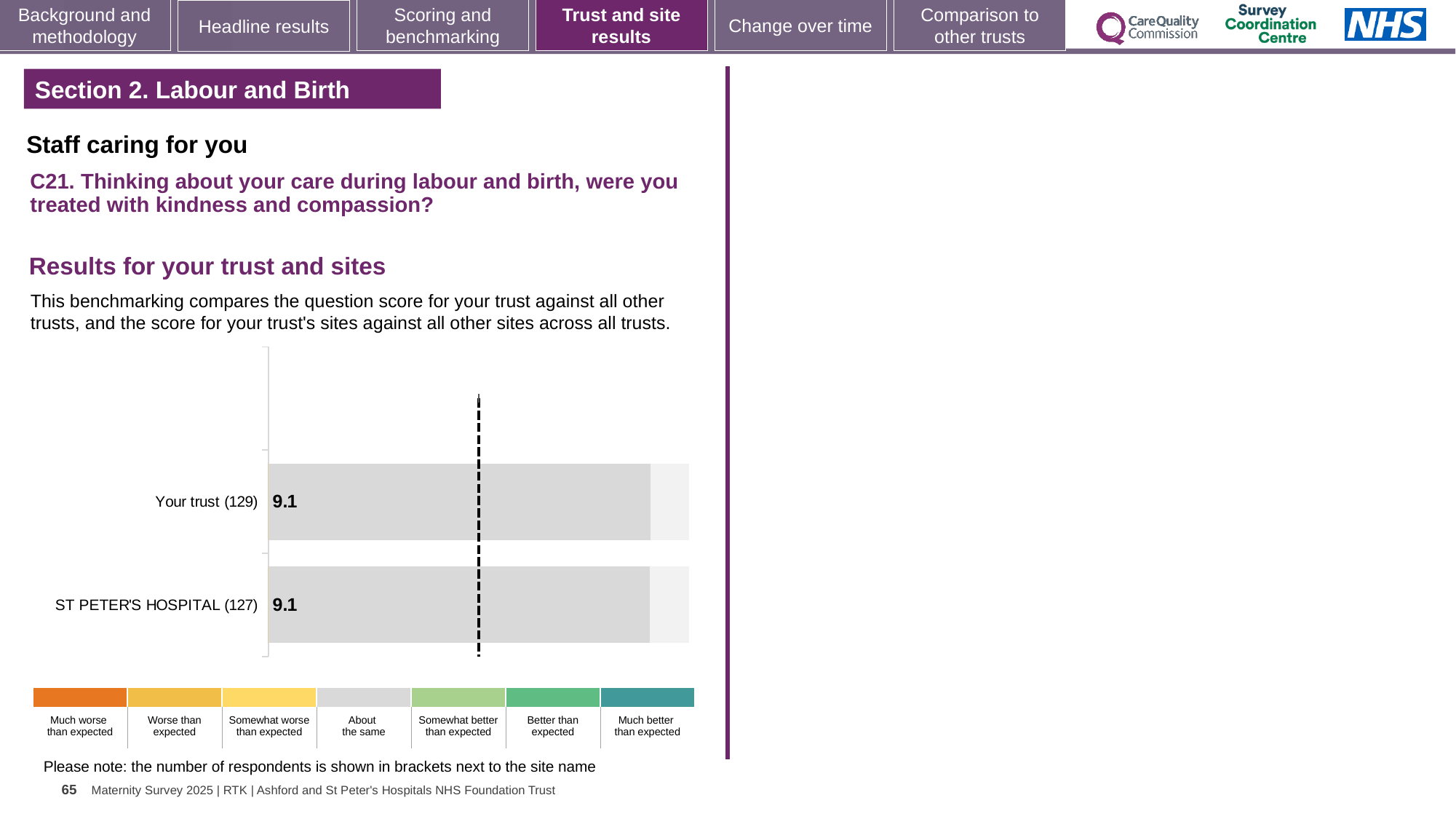
Is the score for Your trust (129) greater or less than 5? greater What kind of chart is shown on the slide? Bar chart Which survey question does the chart relate to? C21. Thinking about your care during labour and birth, were you treated with kindness and compassion? What is the score for ST PETER'S HOSPITAL (127)? 9.1 How many bars are plotted in the chart? 2 How many respondents are shown in brackets for ST PETER'S HOSPITAL? 127 What is the score for Your trust (129)? 9.1 How many respondents are shown in brackets for Your trust? 129 Which benchmarking category does the grey colour of the bars correspond to in the colour key? About the same How many benchmarking categories are listed in the colour key below the chart? 7 What is the difference between the score for Your trust (129) and the score for ST PETER'S HOSPITAL (127)? 0